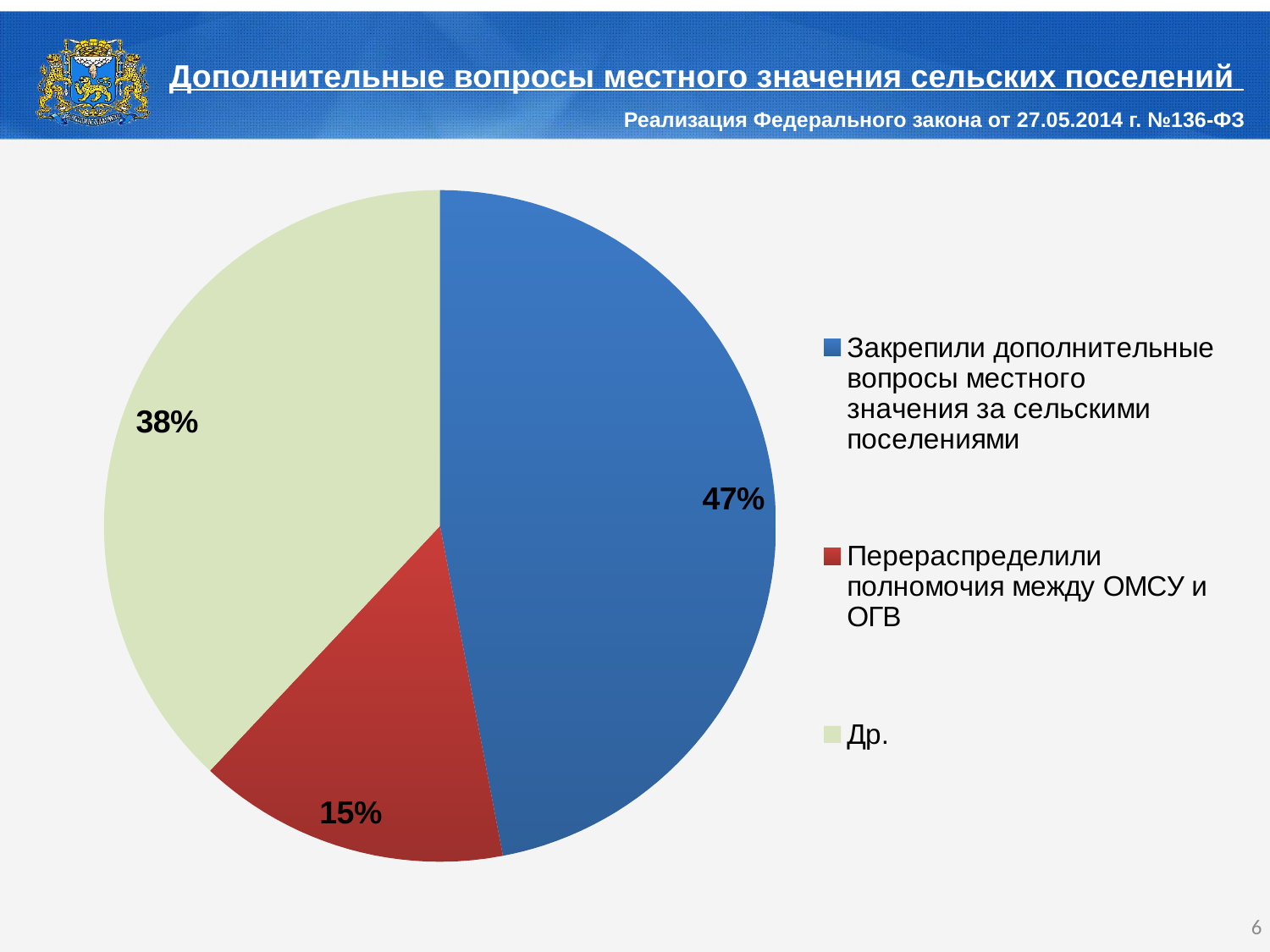
What share of the pie is labelled "Перераспределили полномочия между ОМСУ и ОГВ"? 15% Which category has the largest slice of the pie? Закрепили дополнительные вопросы местного значения за сельскими поселениями How many slices does the pie chart have? 3 How many entries does the legend list? 3 What share of the pie is labelled "Закрепили дополнительные вопросы местного значения за сельскими поселениями"? 47% What type of chart is shown on the slide? Pie chart Which is larger: the "Др." slice or the "Перераспределили полномочия между ОМСУ и ОГВ" slice? Др. What is the difference in percentage points between the "Др." slice and the "Перераспределили полномочия между ОМСУ и ОГВ" slice? 23 What share of the pie is labelled "Др."? 38% What colour is the slice for "Др."? Light green Which category has the smallest slice of the pie? Перераспределили полномочия между ОМСУ и ОГВ What is the difference in percentage points between the largest slice and the "Др." slice? 9